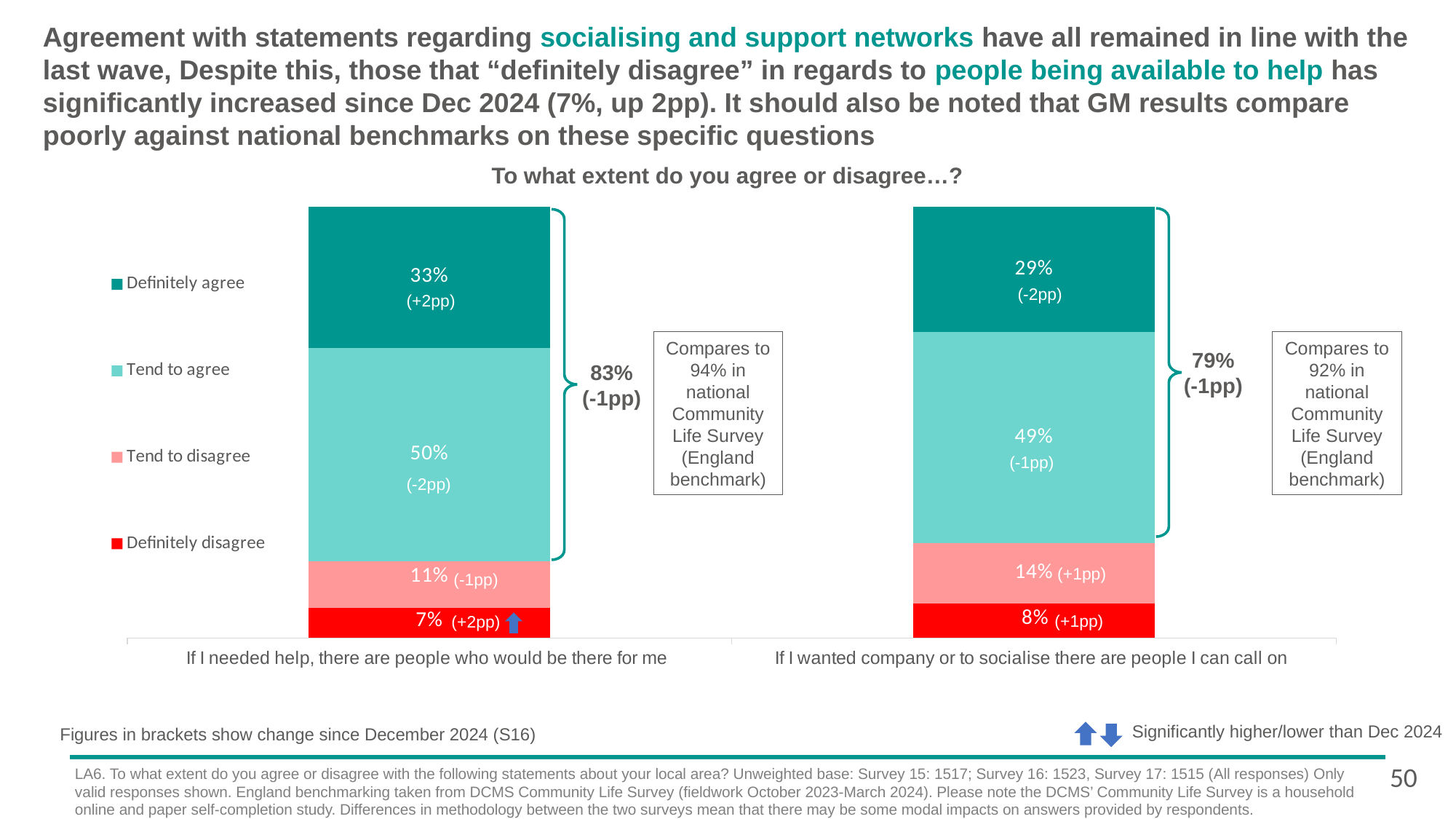
What is the combined agreement shown for 'If I wanted company or to socialise there are people I can call on'? 79% Which statement has the higher 'Definitely disagree' value? If I wanted company or to socialise there are people I can call on Which response category has the smallest share for 'If I wanted company or to socialise there are people I can call on'? Definitely disagree What percentage 'Tend to agree' that if they wanted company or to socialise there are people they can call on? 49% What is the 'Tend to disagree' value for 'If I wanted company or to socialise there are people I can call on'? 14% How many response categories does the legend list? 4 What is the difference between the 'Definitely agree' values for the two statements? 4 percentage points What type of chart is shown on the slide? Stacked bar chart What is the 'Definitely disagree' value for 'If I needed help, there are people who would be there for me'? 7% What percentage of respondents 'Definitely agree' that if they needed help, there are people who would be there for them? 33% Which response category has the largest share for 'If I needed help, there are people who would be there for me'? Tend to agree What is the combined agreement (Definitely agree plus Tend to agree) shown for 'If I needed help, there are people who would be there for me'? 83%